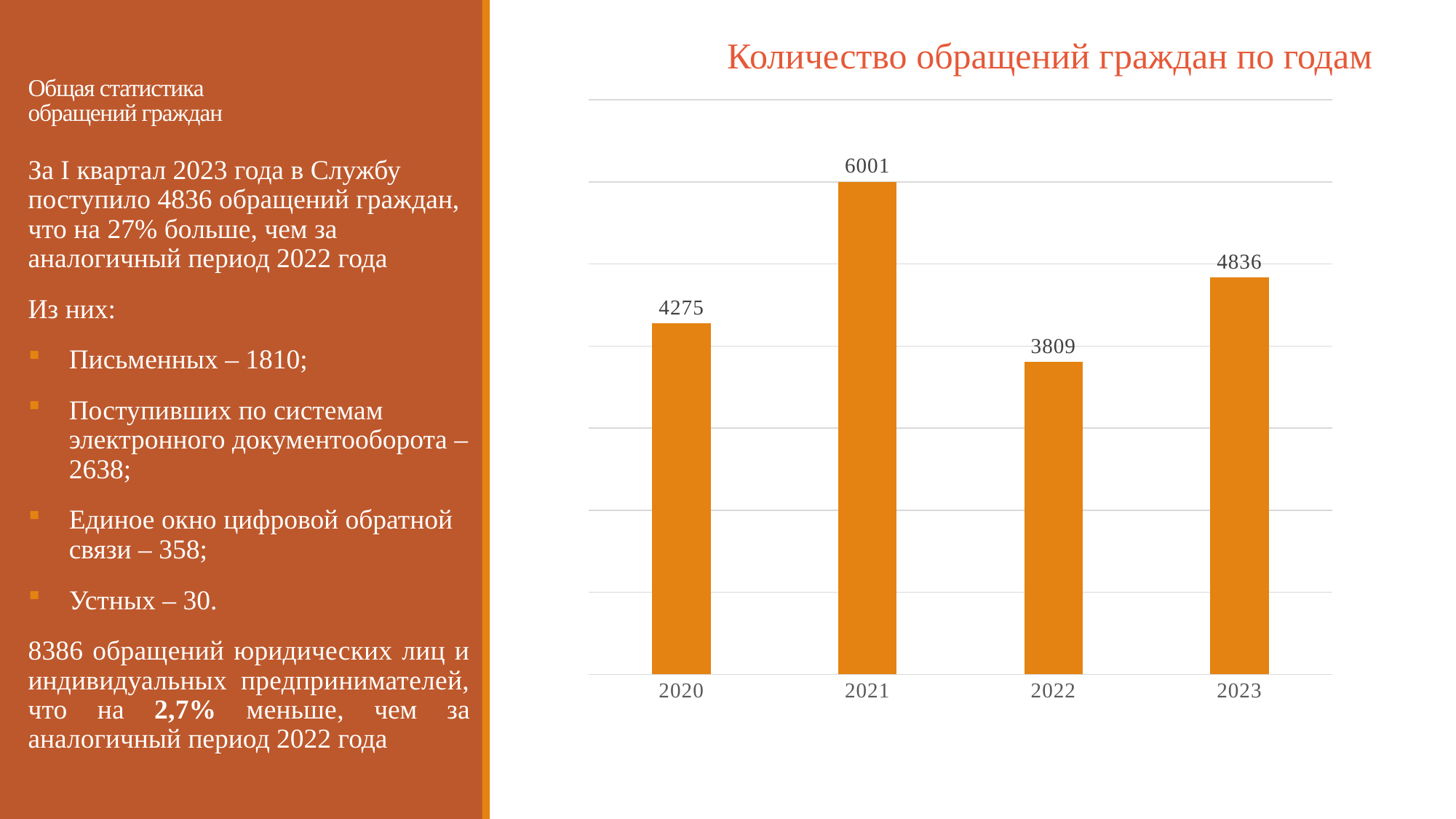
What is the value for 2023 in the chart? 4836 What is the title of the chart? Количество обращений граждан по годам How many years are shown on the x axis of the chart? 4 What kind of chart is shown on the slide? Bar chart What is the value for 2022 in the chart? 3809 What is the value for 2020 in the chart? 4275 Which is larger, the value for 2020 or the value for 2023? 2023 What is the value for 2021 in the chart? 6001 Which year has the lowest value in the chart? 2022 What is the difference between the values for 2023 and 2020? 561 What is the difference between the values for 2021 and 2022? 2192 Which year has the highest value in the chart? 2021